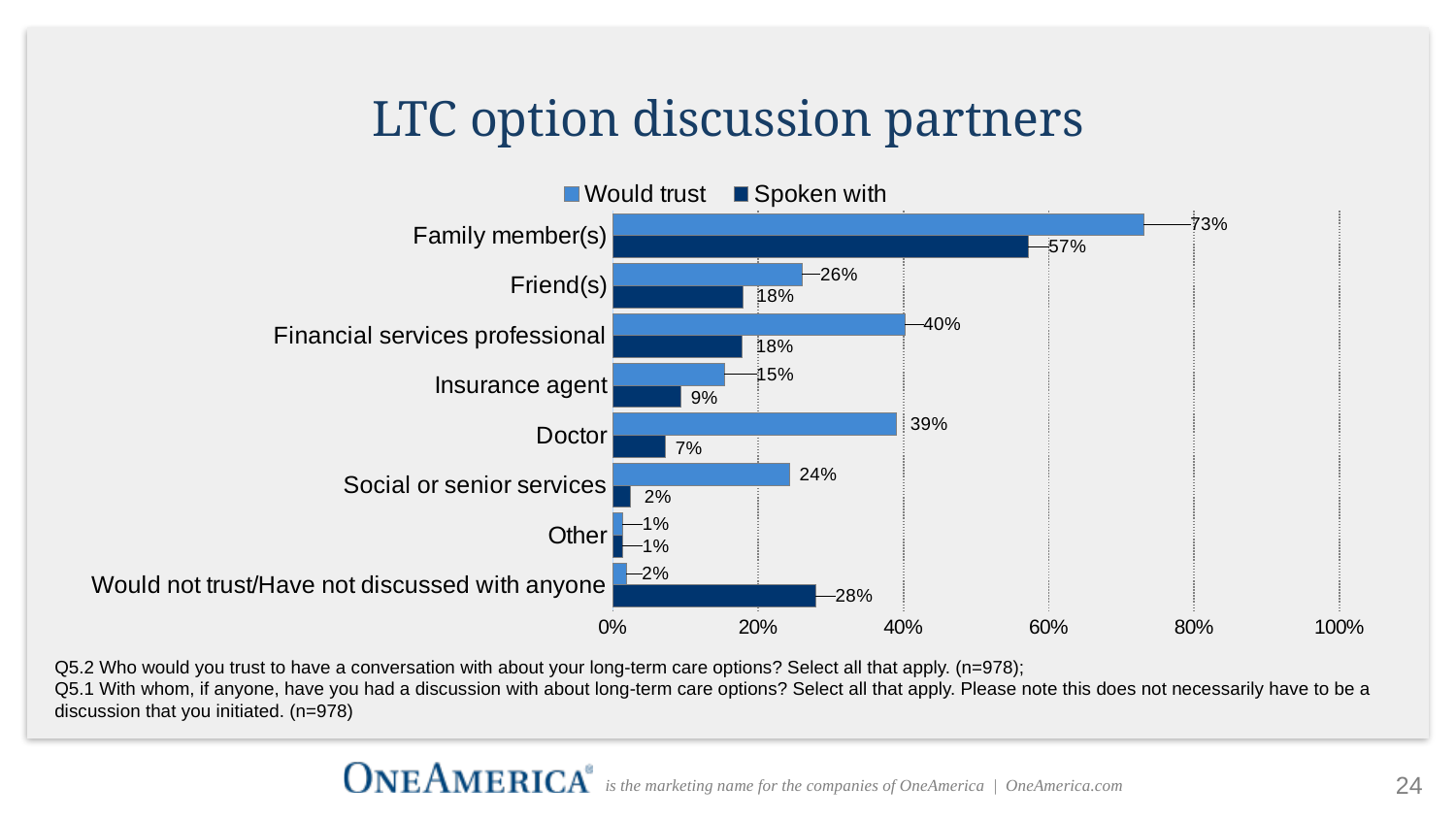
What is the difference between the 'Would trust' and 'Spoken with' values for Family member(s)? 16% How many series does the legend list? 2 What is the title of the chart? LTC option discussion partners What percentage would trust a financial services professional? 40% What is the 'Spoken with' value for 'Would not trust/Have not discussed with anyone'? 28% What kind of chart is shown on the slide? Bar chart Which category has the lowest 'Spoken with' value? Other Is the 'Spoken with' value for Family member(s) greater or less than 40%? greater What percentage have spoken with a doctor? 7% How many categories are shown on the chart? 8 Which category has the highest 'Would trust' value? Family member(s) Which is larger: the 'Would trust' value for Doctor or for Social or senior services? Doctor